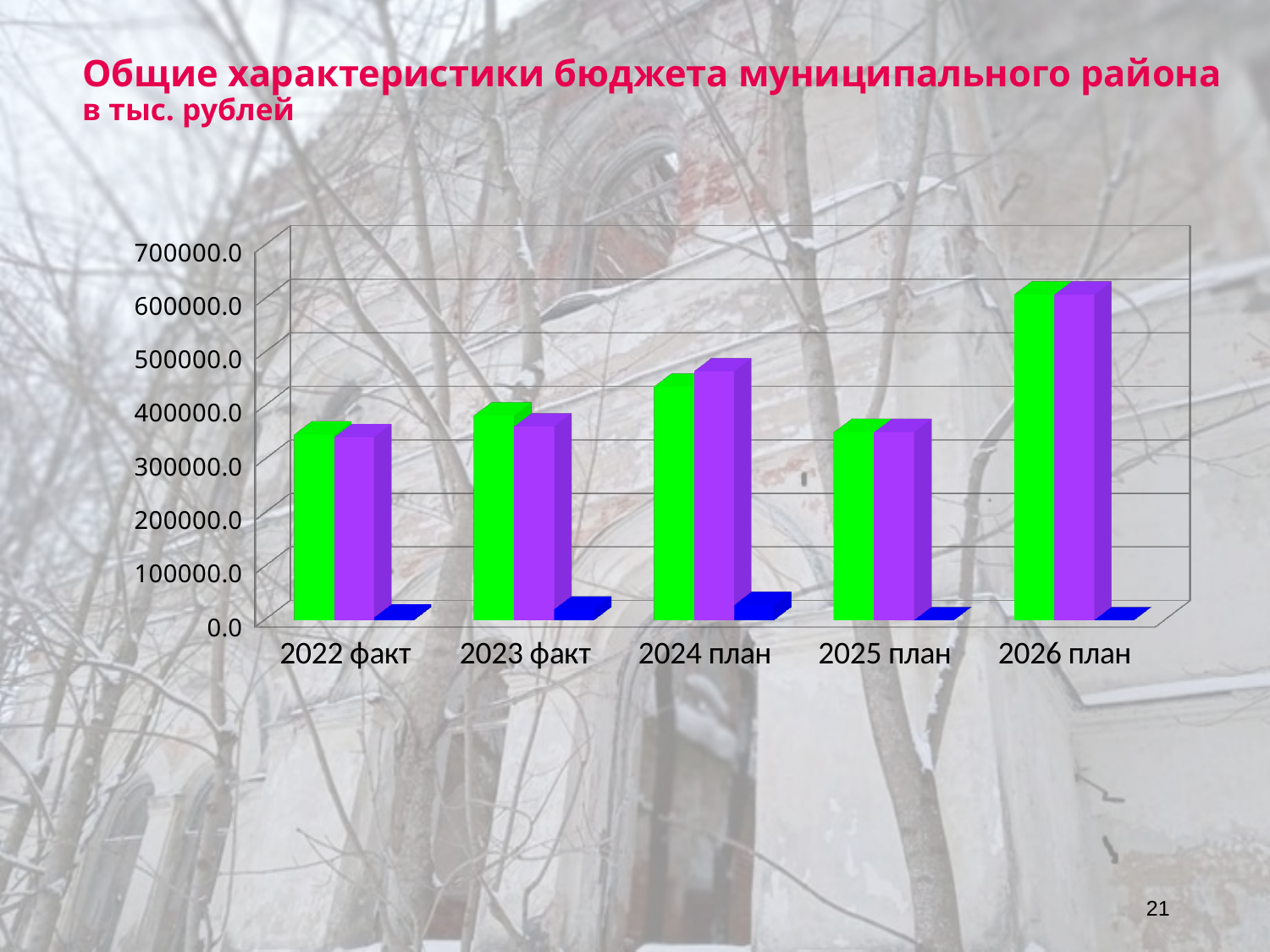
For 2024 план, which bar is taller: the green bar or the purple bar? the purple bar What kind of chart is shown on the slide? bar chart Is the green bar for 2022 факт greater or less than 300000.0? greater Which category has the tallest purple bar in the chart? 2026 план How many categories are shown on the x axis of the chart? 5 Is the purple bar for 2024 план greater or less than 500000.0? less Is the blue bar for 2023 факт greater or less than 100000.0? less Which category has the tallest green bar in the chart? 2026 план How many bars are plotted for each category in the chart? 3 What unit is stated under the chart title on the slide? в тыс. рублей Which is taller: the green bar for 2024 план or the green bar for 2025 план? the green bar for 2024 план